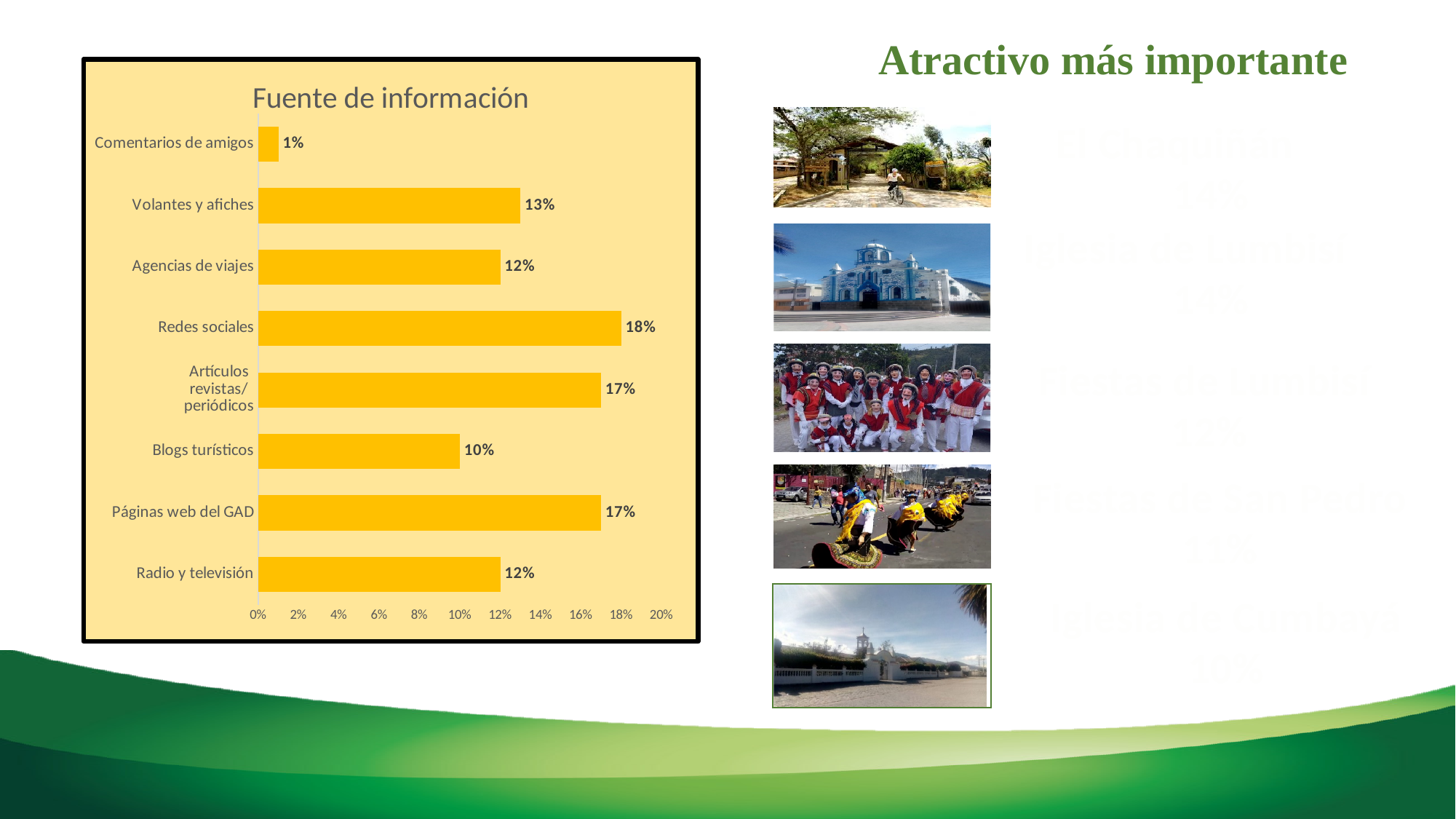
Which category has the lowest value in the Fuente de información chart? Comentarios de amigos In the Fuente de información chart, which is larger: Volantes y afiches or Agencias de viajes? Volantes y afiches How many categories are shown in the Fuente de información chart? 8 What is the title of the chart on the slide? Fuente de información What is the value for Volantes y afiches in the Fuente de información chart? 13% What is the value for Redes sociales in the Fuente de información chart? 18% What kind of chart is the Fuente de información chart? Bar chart Which category has the highest value in the Fuente de información chart? Redes sociales What is the value for Páginas web del GAD in the Fuente de información chart? 17% What is the difference between the values for Redes sociales and Blogs turísticos in the Fuente de información chart? 8% What is the value for Blogs turísticos in the Fuente de información chart? 10% What is the value for Comentarios de amigos in the Fuente de información chart? 1%